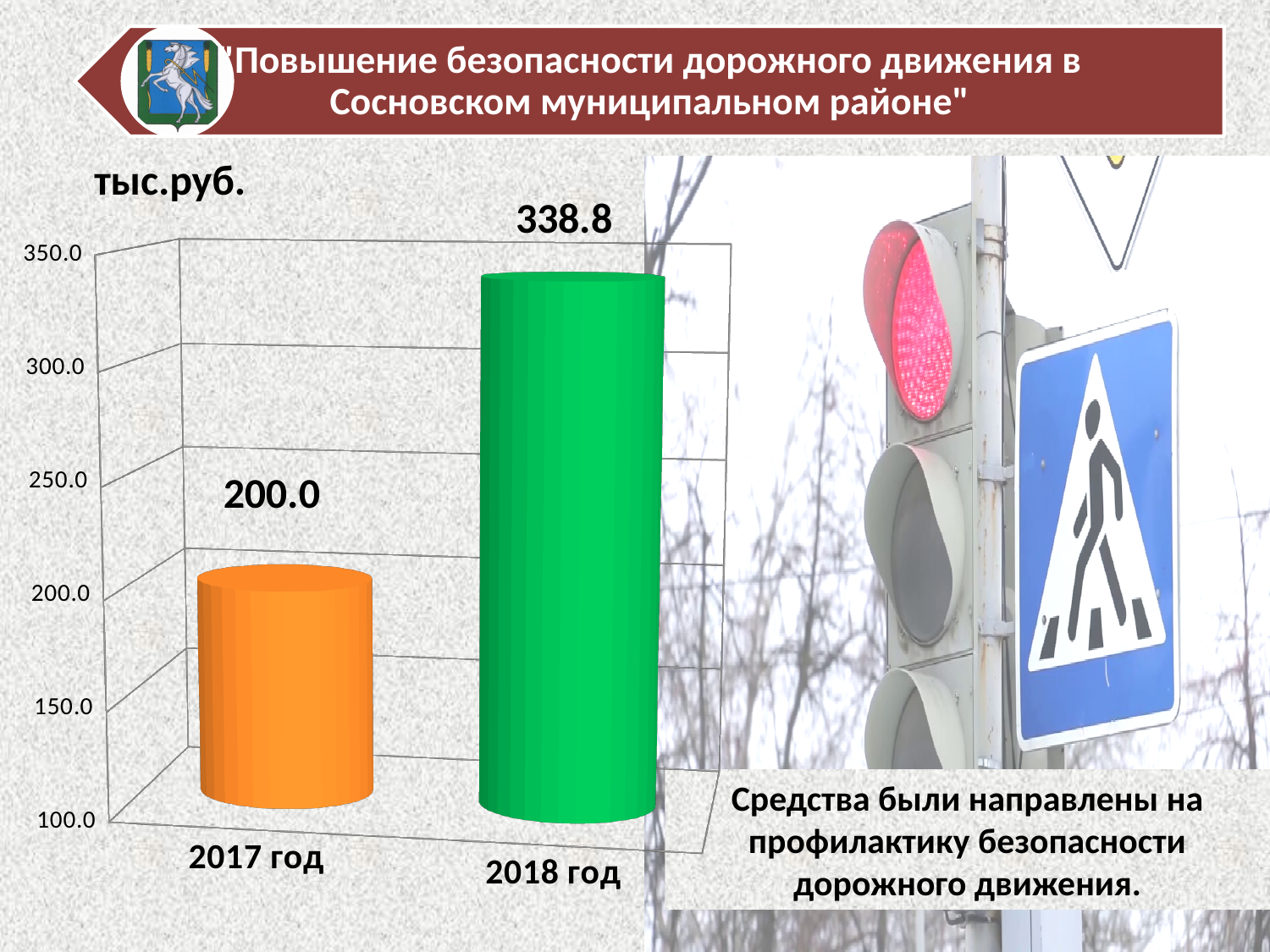
What kind of chart is shown on the slide? bar chart Which is larger, the value for 2017 год or 2018 год? 2018 год How many categories are shown on the chart? 2 Which year has the highest value? 2018 год What is the difference between the values for 2018 год and 2017 год? 138.8 Do the values rise or fall from 2017 год to 2018 год? rise Which year has the lowest value? 2017 год What is the value for 2018 год? 338.8 Is the value for 2018 год greater or less than 300.0? greater What is the value for 2017 год? 200.0 What unit is shown above the chart's vertical axis? тыс.руб. Is the value for 2017 год greater or less than 250.0? less